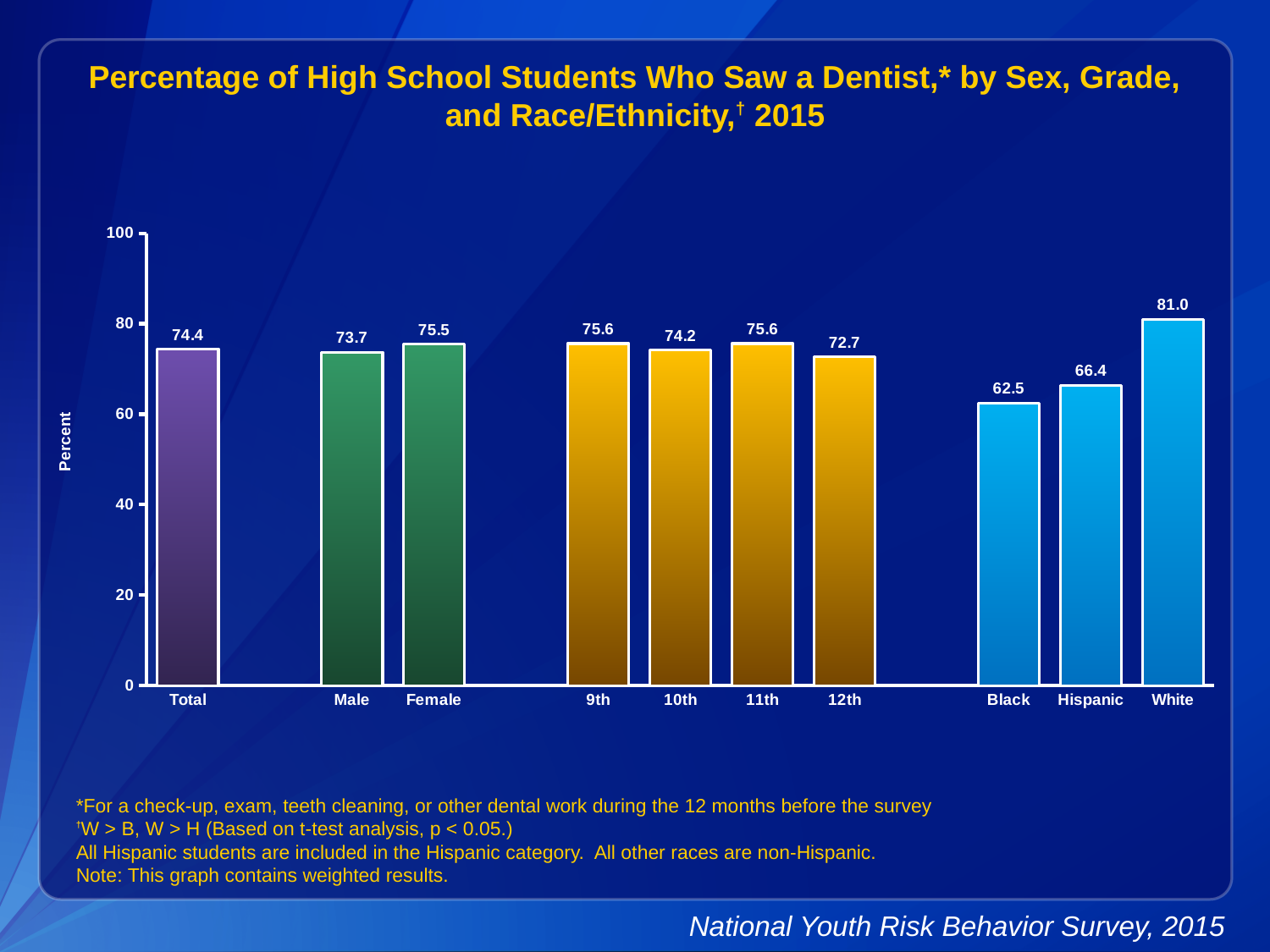
What is the difference between the values for White and Black students? 18.5 Is the value for Hispanic students greater or less than 80? less How many categories are shown on the x axis? 10 Which is larger, the value for 9th grade or 12th grade? 9th Which category has the highest value? White Which category has the lowest value? Black What is the value for Black students? 62.5 What percentage of female students saw a dentist? 75.5 What kind of chart is this? bar chart What is the difference between the values for Female and Male students? 1.8 What is the label on the y axis? Percent What is the value for Total? 74.4